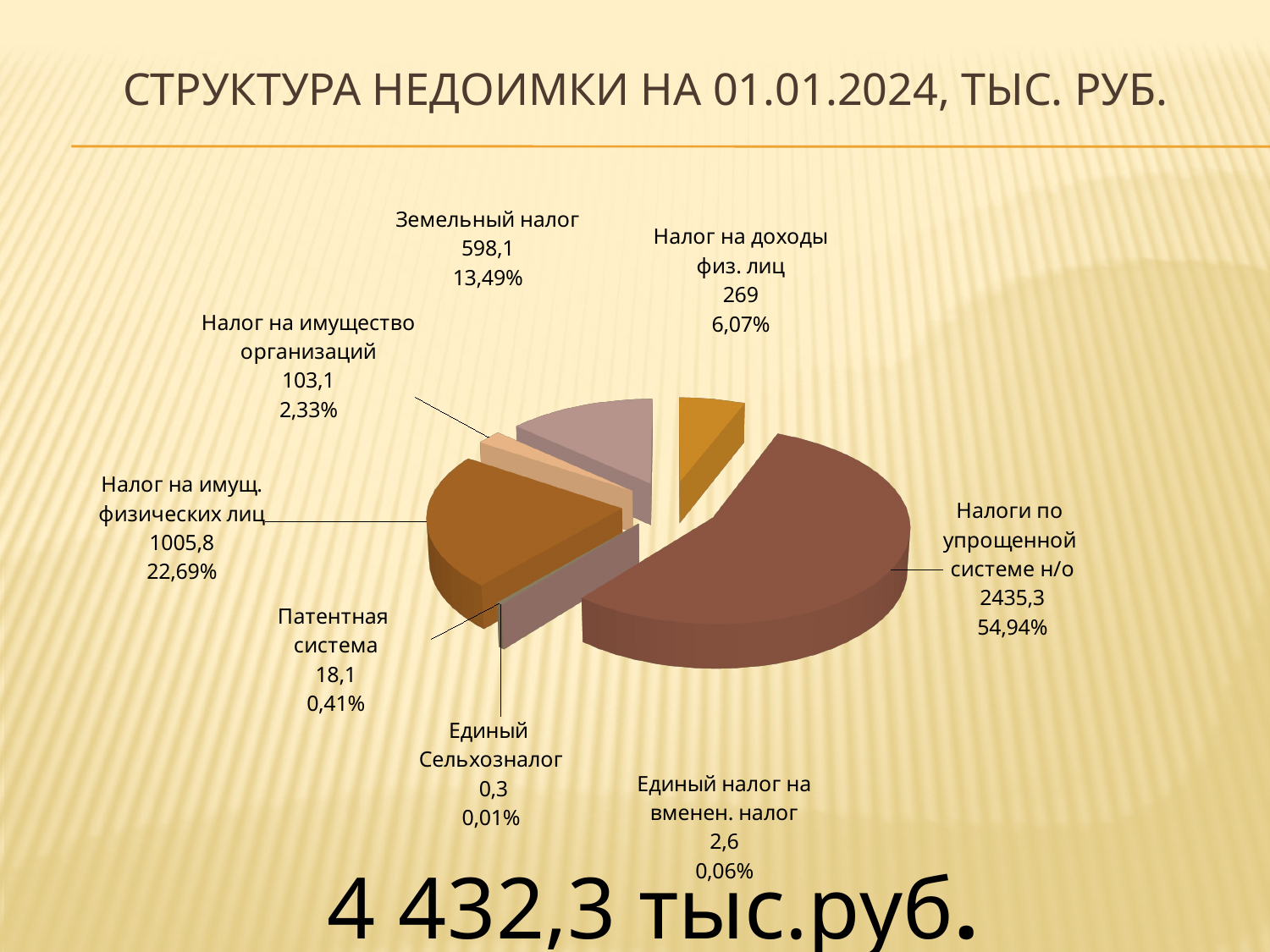
Which category has the largest slice of the pie? Налоги по упрощенной системе н/о What is the value for Единый налог на вменен. налог? 2,6 What is the value for Земельный налог? 598,1 Which is larger: Налог на имущество организаций or Патентная система? Налог на имущество организаций How many categories are shown in the pie chart? 8 What is the difference between the values for Налог на имущ. физических лиц and Земельный налог? 407,7 What percentage is shown for Налог на доходы физ. лиц? 6,07% What share of the pie does Налог на имущ. физических лиц represent? 22,69% Which category has the smallest slice of the pie? Единый Сельхозналог What is the value for Налоги по упрощенной системе н/о? 2435,3 What type of chart is shown on the slide? pie chart What is the title of the chart on the slide? СТРУКТУРА НЕДОИМКИ НА 01.01.2024, ТЫС. РУБ.